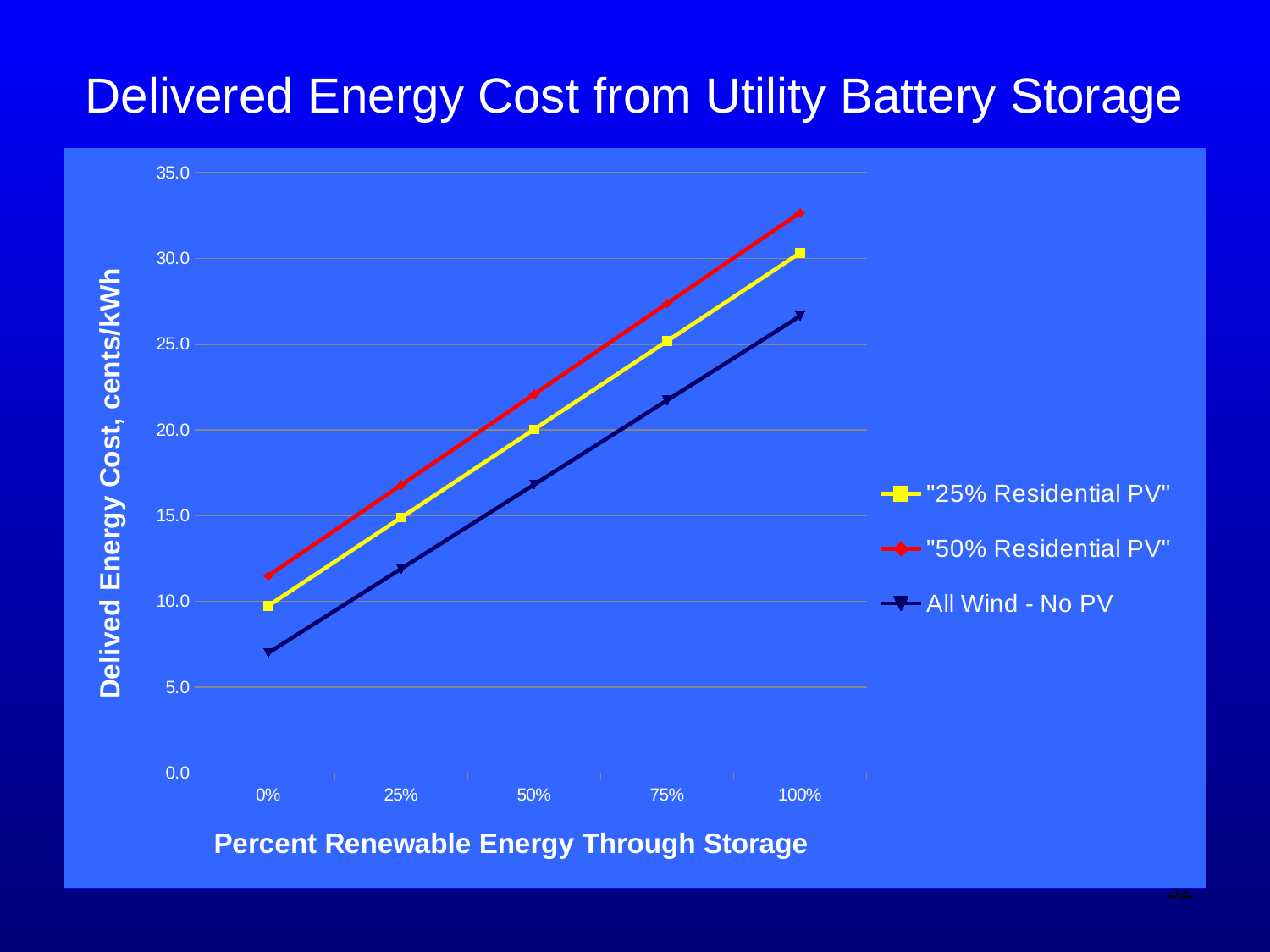
Do the delivered energy cost values rise or fall as the percent renewable energy through storage increases? Rise How many series does the legend list? 3 What is the title of the y axis? Delived Energy Cost, cents/kWh Is the value for "50% Residential PV" at 100% greater or less than 30.0? greater Is the value for "50% Residential PV" at 25% greater or less than 15.0? greater Is the value for All Wind - No PV at 0% greater or less than 10.0? less How many points are plotted along the x axis for each series? 5 What kind of chart is shown on the slide? Line chart Which series has the lowest delivered energy cost at 0%? All Wind - No PV Which series has the highest delivered energy cost at 100%? "50% Residential PV" At 50%, which series has the higher delivered energy cost, "25% Residential PV" or All Wind - No PV? "25% Residential PV"